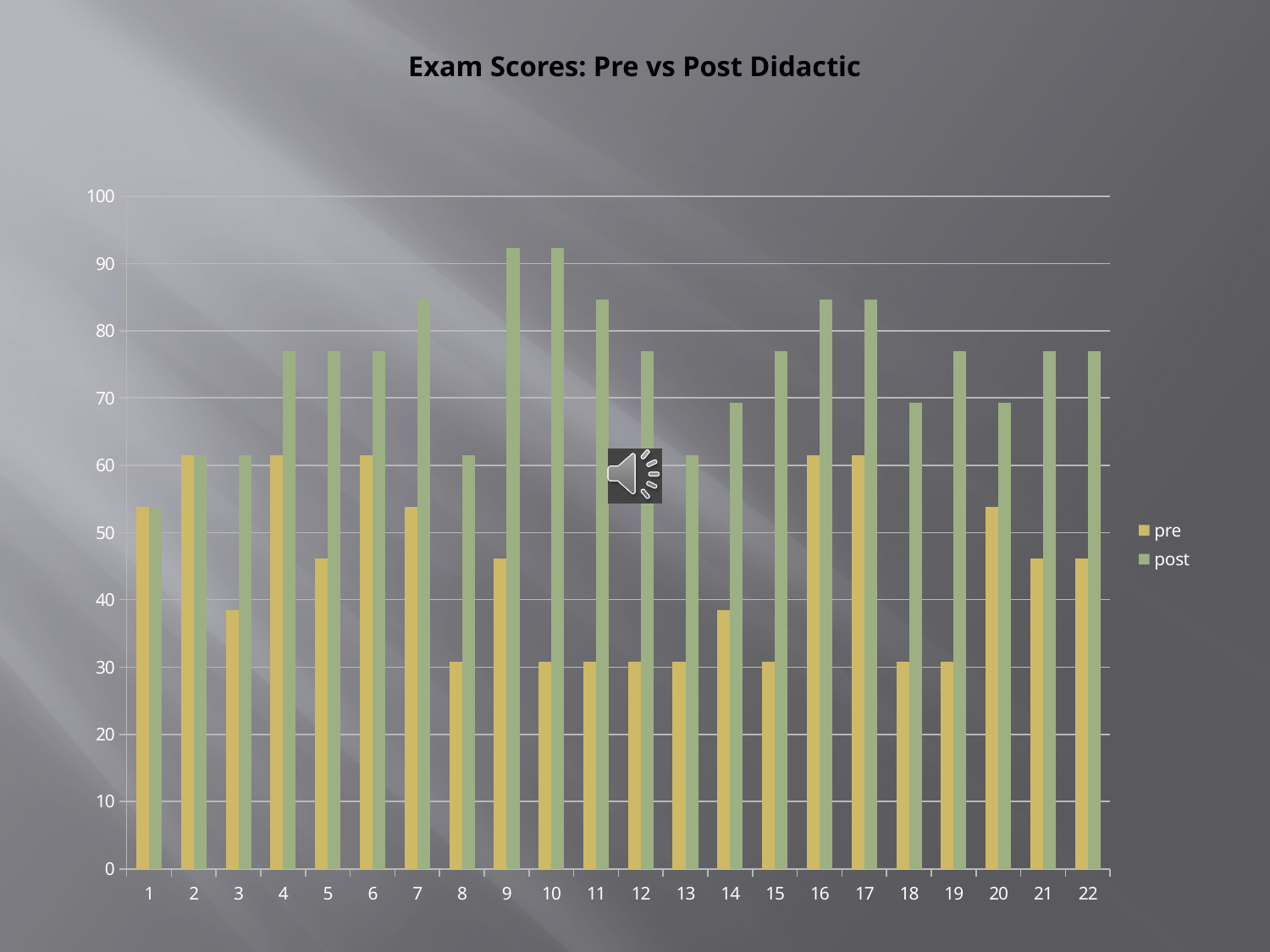
How many categories are shown on the x axis? 22 How many series does the legend list? 2 What kind of chart is shown on the slide? bar chart Is the post value for category 7 greater or less than 80? greater For category 3, which is larger, the pre value or the post value? post What is the title of the chart? Exam Scores: Pre vs Post Didactic Is the pre value for category 8 greater or less than 40? less Which series is shown in green? post Is the post value for category 9 greater or less than 90? greater Which category has the lowest post value? 1